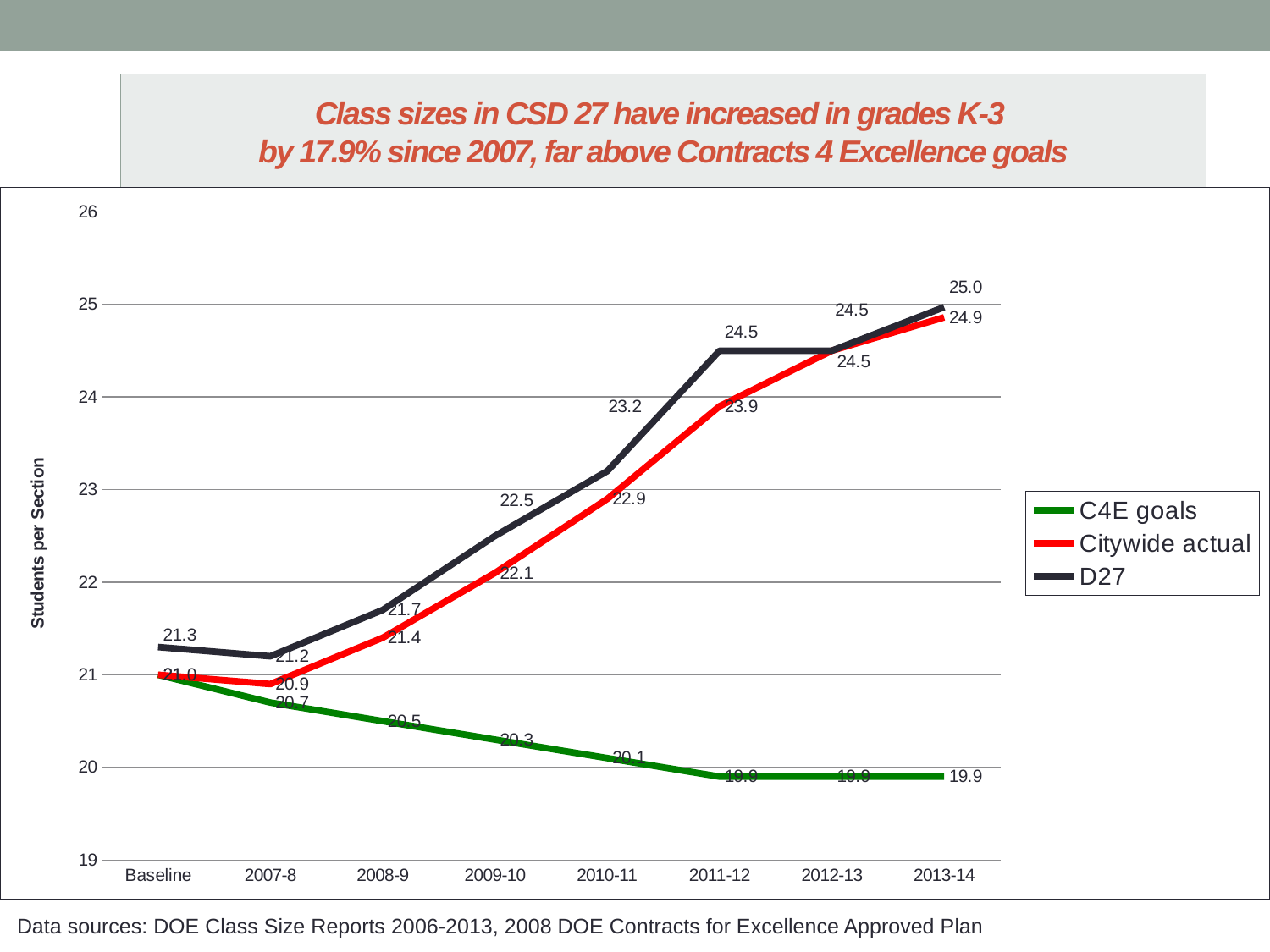
What kind of chart is shown on the slide? Line chart Does the D27 series rise or fall from Baseline to 2013-14? Rises What is the Citywide actual value for 2009-10? 22.1 What is the D27 value for 2010-11? 23.2 What is the Citywide actual value for 2013-14? 24.9 What is the D27 value for 2013-14? 25.0 How many series does the legend list? 3 What is the C4E goals value for 2013-14? 19.9 What is the difference between the D27 and Citywide actual values in 2013-14? 0.1 In 2011-12, which is larger: D27 or Citywide actual? D27 What is the label on the y axis? Students per Section How many points along the x axis are plotted for each series? 8